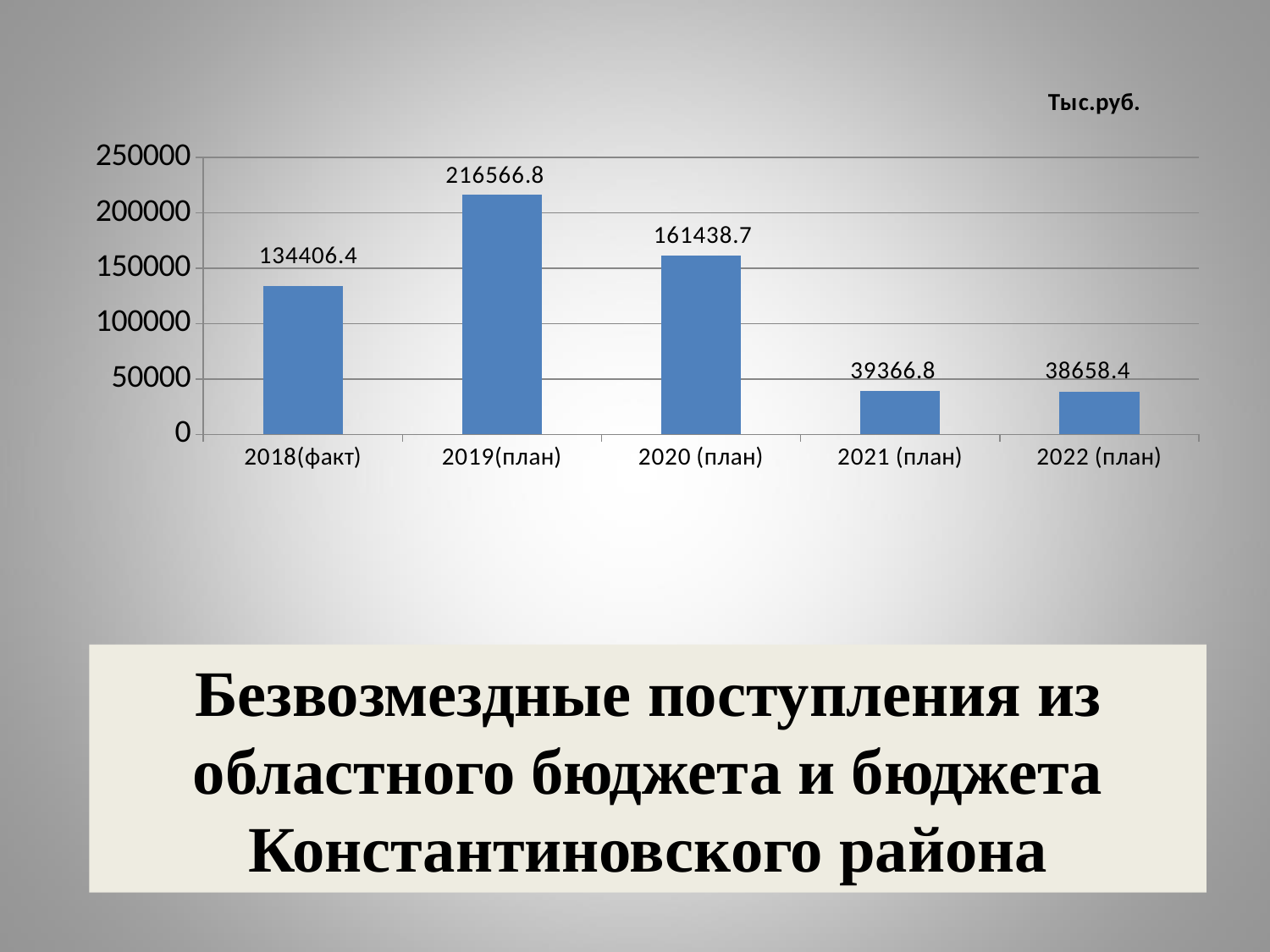
Is the value for 2021 (план) greater or less than 50000? less What is the value for 2018(факт)? 134406.4 Which category has the lowest value? 2022 (план) What kind of chart is shown on the slide? bar chart What is the difference between the values for 2021 (план) and 2022 (план)? 708.4 What is the value for 2020 (план)? 161438.7 What is the value for 2022 (план)? 38658.4 What is the difference between the values for 2019(план) and 2020 (план)? 55128.1 Which category has the highest value? 2019(план) How many categories are shown on the x axis? 5 What unit is indicated in the top right corner of the chart? Тыс.руб. Which is larger, the value for 2018(факт) or the value for 2020 (план)? 2020 (план)